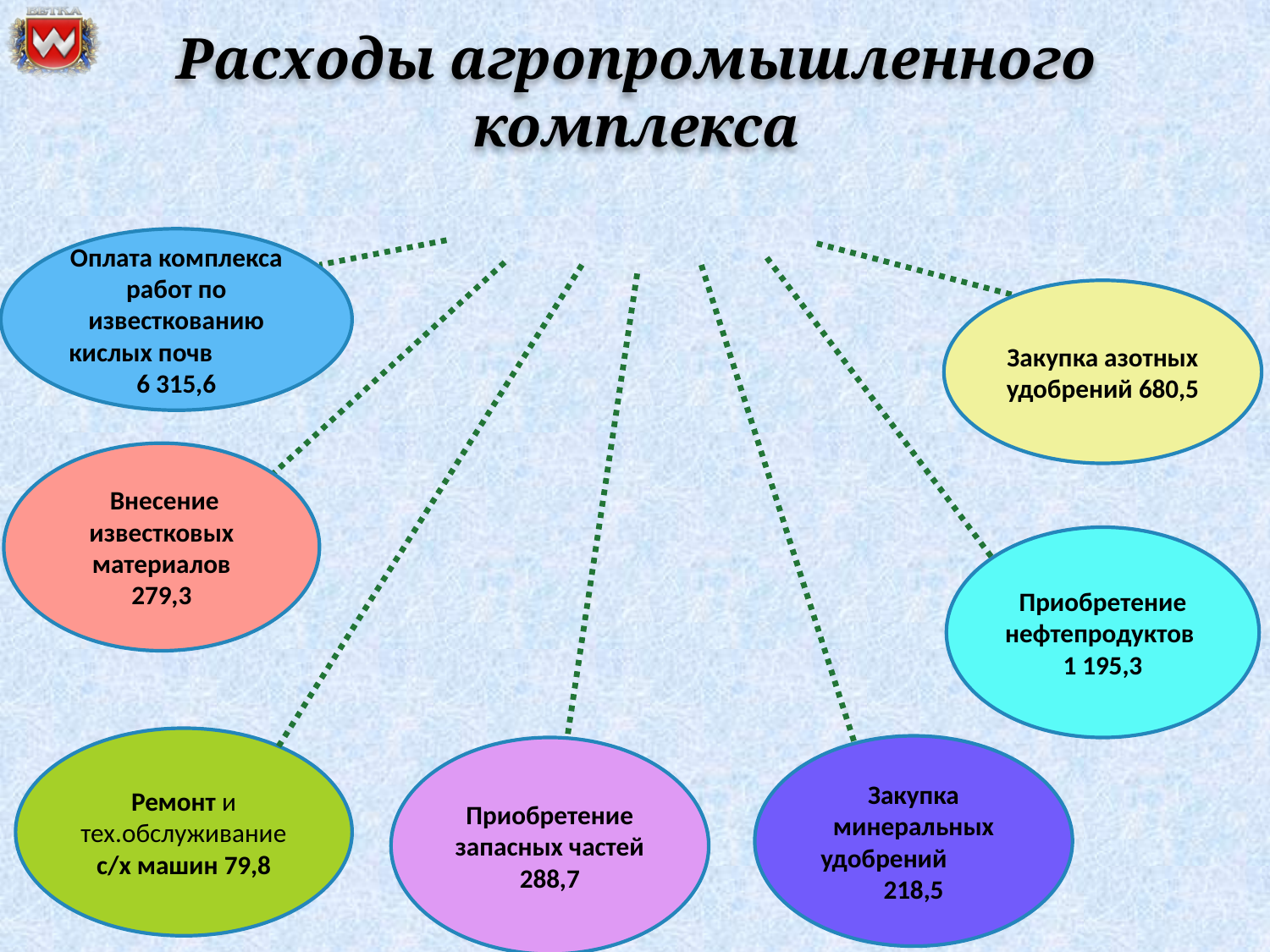
What is the difference between the values for «Приобретение нефтепродуктов» and «Закупка азотных удобрений»? 514,8 What value is shown for «Закупка азотных удобрений»? 680,5 Which expense item in the diagram has the lowest value? Ремонт и тех.обслуживание с/х машин What is the title of the slide? Расходы агропромышленного комплекса What is the difference between the values for «Приобретение запасных частей» and «Внесение известковых материалов»? 9,4 What value is shown for «Оплата комплекса работ по известкованию кислых почв»? 6 315,6 What value is shown for «Ремонт и тех.обслуживание с/х машин»? 79,8 Which expense item in the diagram has the highest value? Оплата комплекса работ по известкованию кислых почв Which is larger: the value for «Закупка азотных удобрений» or for «Закупка минеральных удобрений»? Закупка азотных удобрений What value is shown for «Закупка минеральных удобрений»? 218,5 What value is shown for «Приобретение нефтепродуктов» in the diagram? 1 195,3 How many expense items (ovals) are shown in the diagram? 7